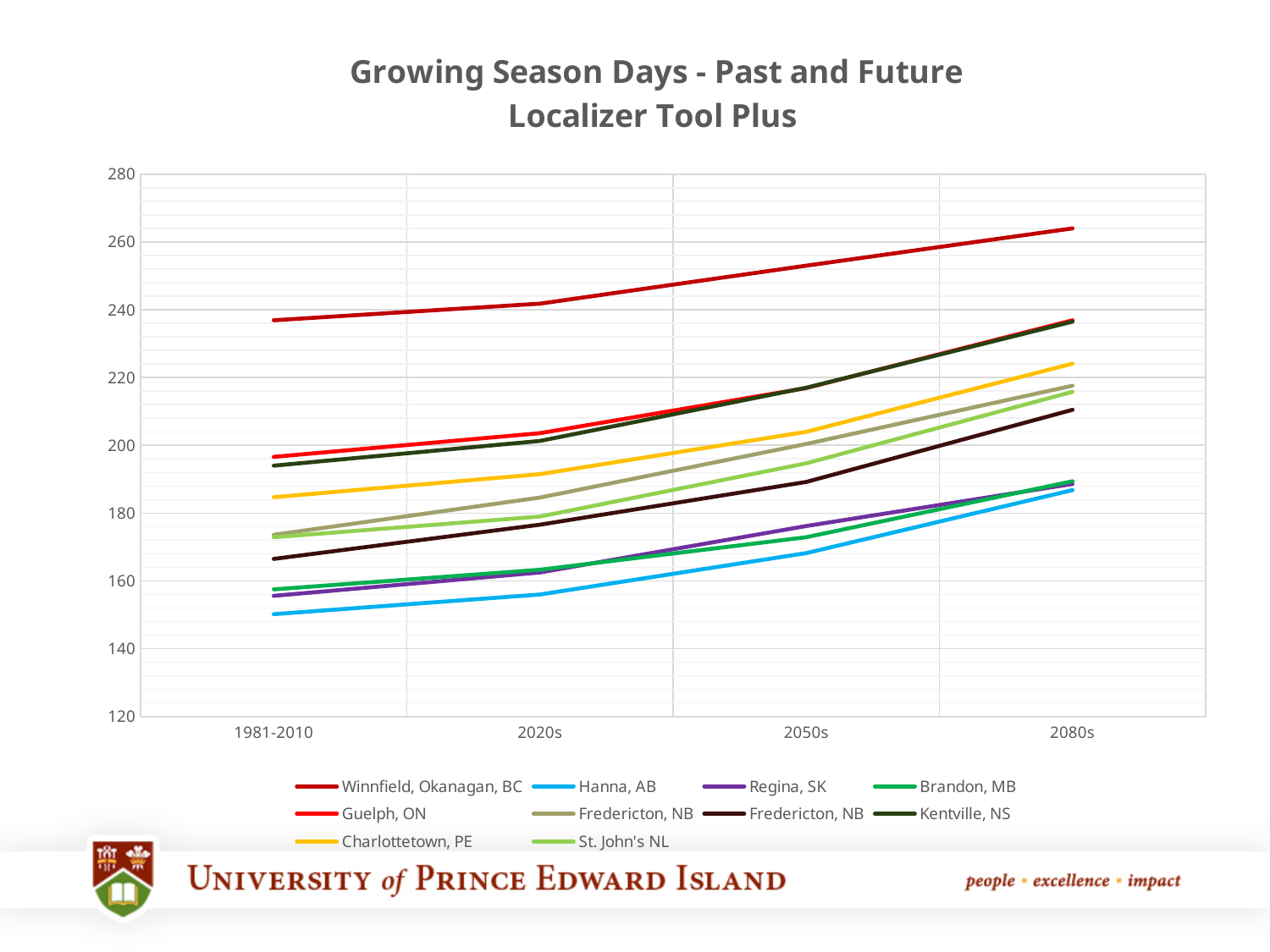
Is the value for Hanna, AB in the 2080s greater or less than 200? less Is the value for Hanna, AB in the 1981-2010 period greater or less than 160? less Is the value for Kentville, NS in the 1981-2010 period greater or less than 200? less How many time periods are shown along the x axis? 4 In the 2050s, which has more growing season days: Charlottetown, PE or Hanna, AB? Charlottetown, PE What is the title of the chart? Growing Season Days - Past and Future Localizer Tool Plus Which location has the highest growing season days in the 2080s? Winnfield, Okanagan, BC What kind of chart is shown on the slide? line chart How many series does the legend list? 10 Which location has the lowest growing season days in the 1981-2010 period? Hanna, AB Do the growing season days for Winnfield, Okanagan, BC rise or fall from 1981-2010 to the 2080s? rise